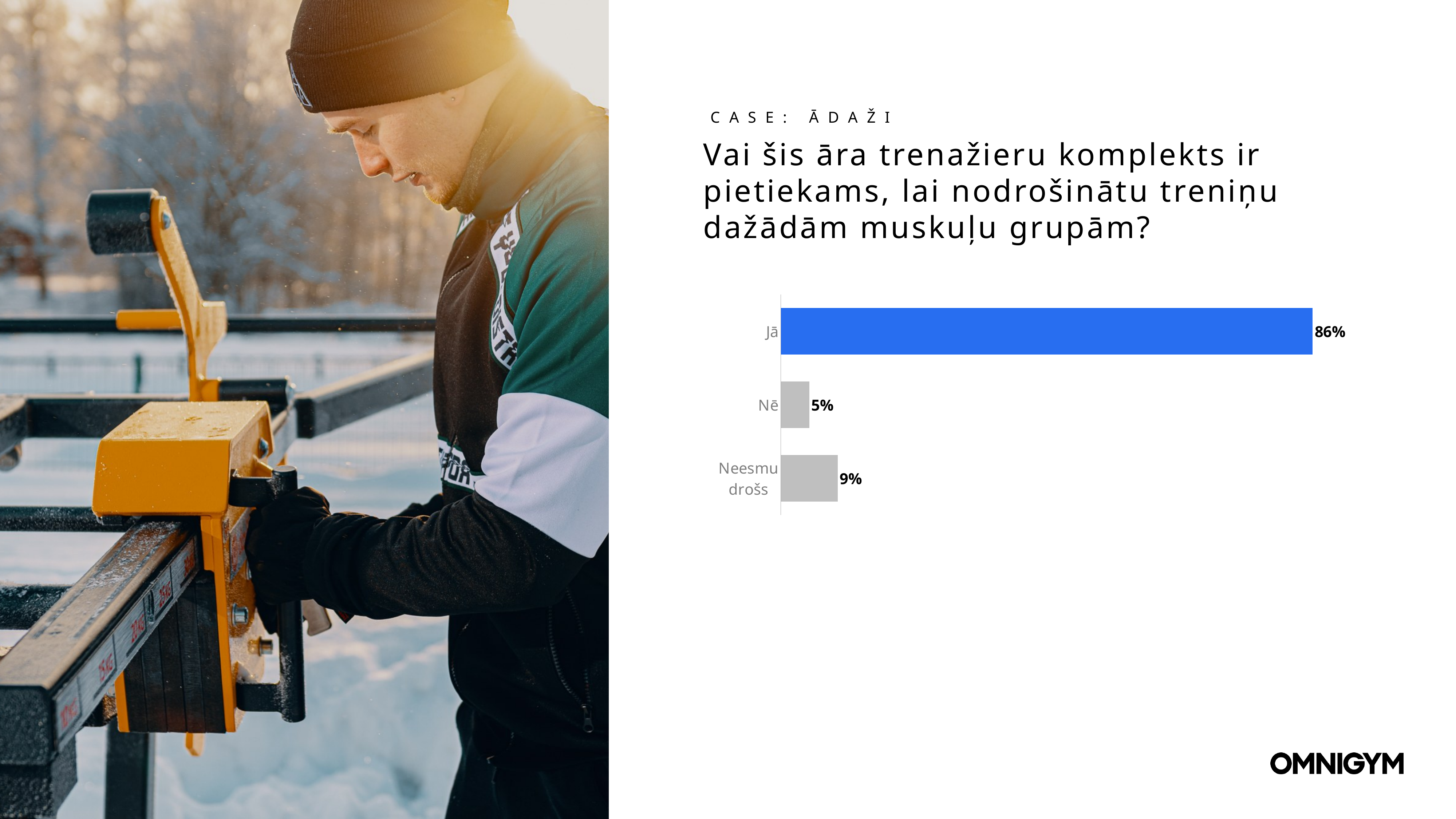
Which is larger, the value for Nē or the value for Neesmu drošs? Neesmu drošs What kind of chart is shown on the slide? bar chart How many categories are shown in the chart? 3 What is the value for Nē? 5% What is the value for Jā? 86% What is the value for Neesmu drošs? 9% Which category has the highest value? Jā What is the difference between the values for Neesmu drošs and Nē? 4% What is the total of the three values shown in the chart? 100% Which category has the lowest value? Nē What is the difference between the values for Jā and Neesmu drošs? 77% Which bar is coloured blue rather than grey? Jā